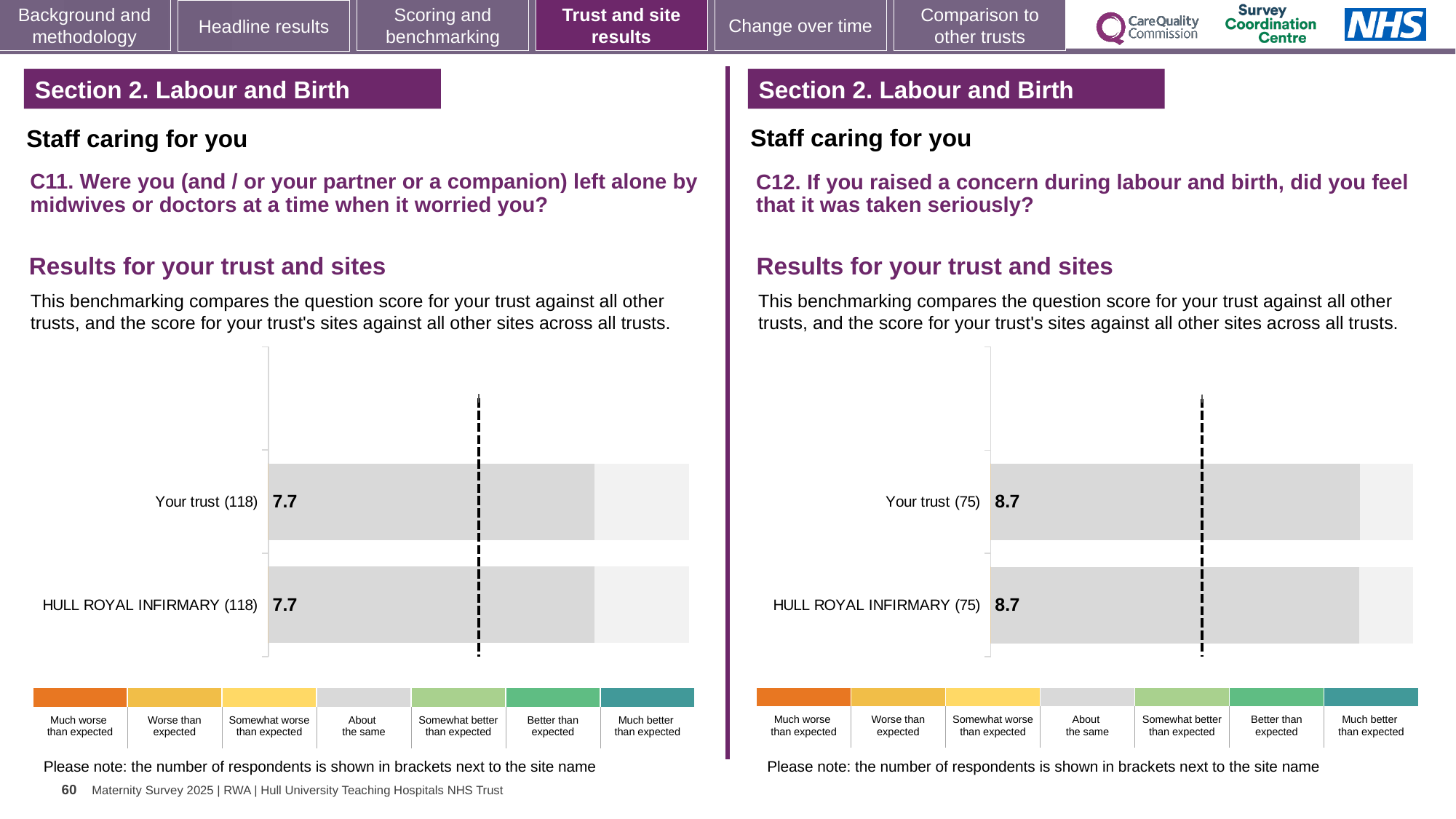
On the right chart (C12), what is the difference between the score for Your trust and the score for HULL ROYAL INFIRMARY? 0 On the left chart (C11), what is the difference between the score for Your trust and the score for HULL ROYAL INFIRMARY? 0 What type of chart is used on the left (C11) to show the results for your trust and sites? Bar chart On the left chart (C11), which benchmark category does the grey colour of the bars correspond to in the legend? About the same Is the score for Your trust on the right chart (C12) greater or less than the score for Your trust on the left chart (C11)? greater On the left chart (C11), what is the score for Your trust (118)? 7.7 On the left chart (C11), what is the score for HULL ROYAL INFIRMARY (118)? 7.7 How many bars are plotted on the right chart (C12)? 2 On the right chart (C12), what is the score for HULL ROYAL INFIRMARY (75)? 8.7 On the right chart (C12), what is the score for Your trust (75)? 8.7 How many respondents are shown in brackets for Your trust on the right chart (C12)? 75 How many bars are plotted on the left chart (C11)? 2